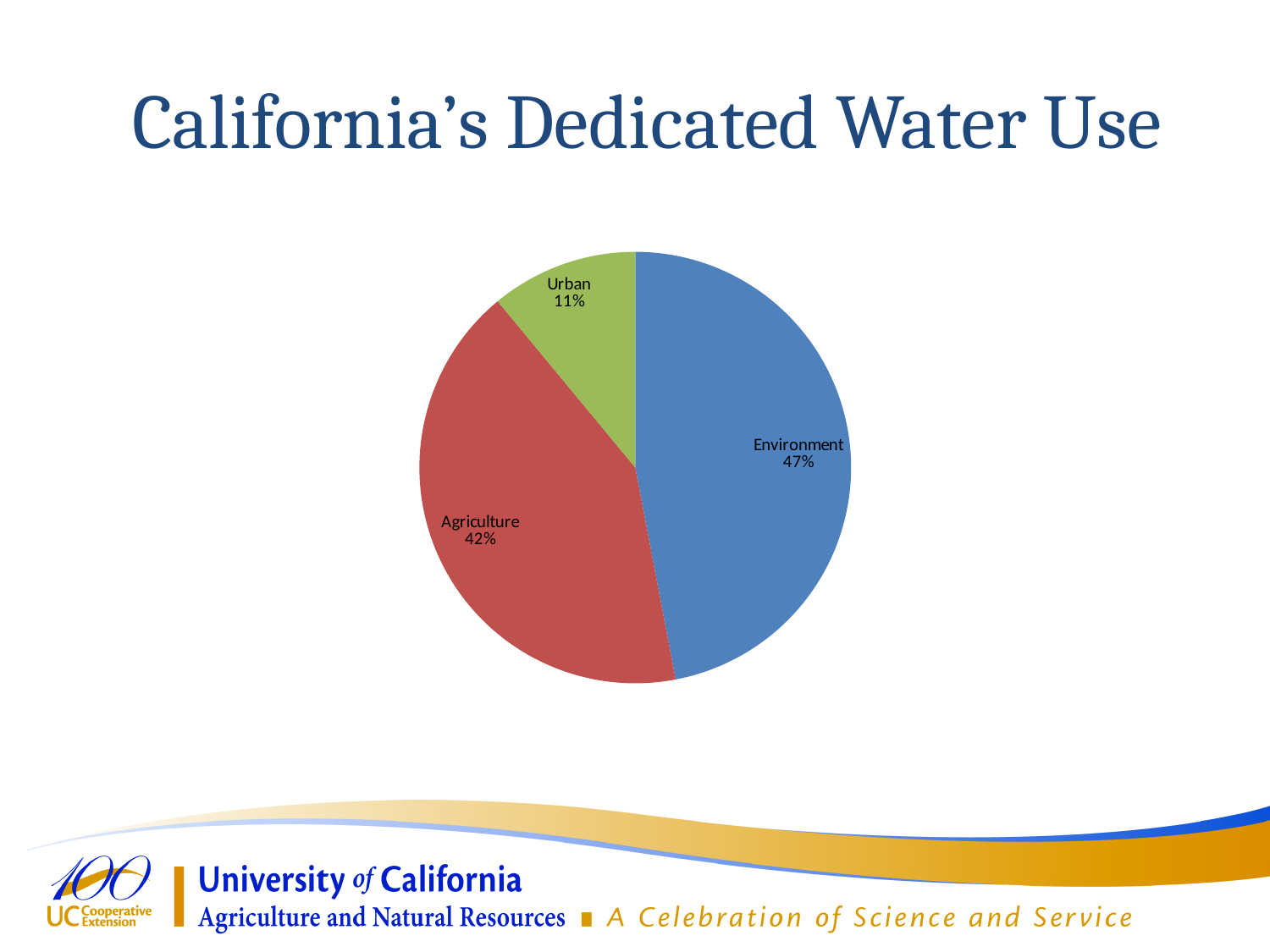
What share of California's dedicated water use goes to Agriculture? 42% What is the title of the chart on the slide? California's Dedicated Water Use What is the difference in percentage points between the Environment and Agriculture shares? 5 Which category has the largest share of California's dedicated water use? Environment What is the difference in percentage points between the Agriculture and Urban shares? 31 What share of California's dedicated water use goes to Urban? 11% What colour is the Agriculture slice of the pie chart? Red What share of California's dedicated water use goes to Environment? 47% Which is larger, the Agriculture share or the Urban share? Agriculture What kind of chart is shown on the slide? Pie chart Which category has the smallest share of California's dedicated water use? Urban How many categories are shown in the pie chart? 3